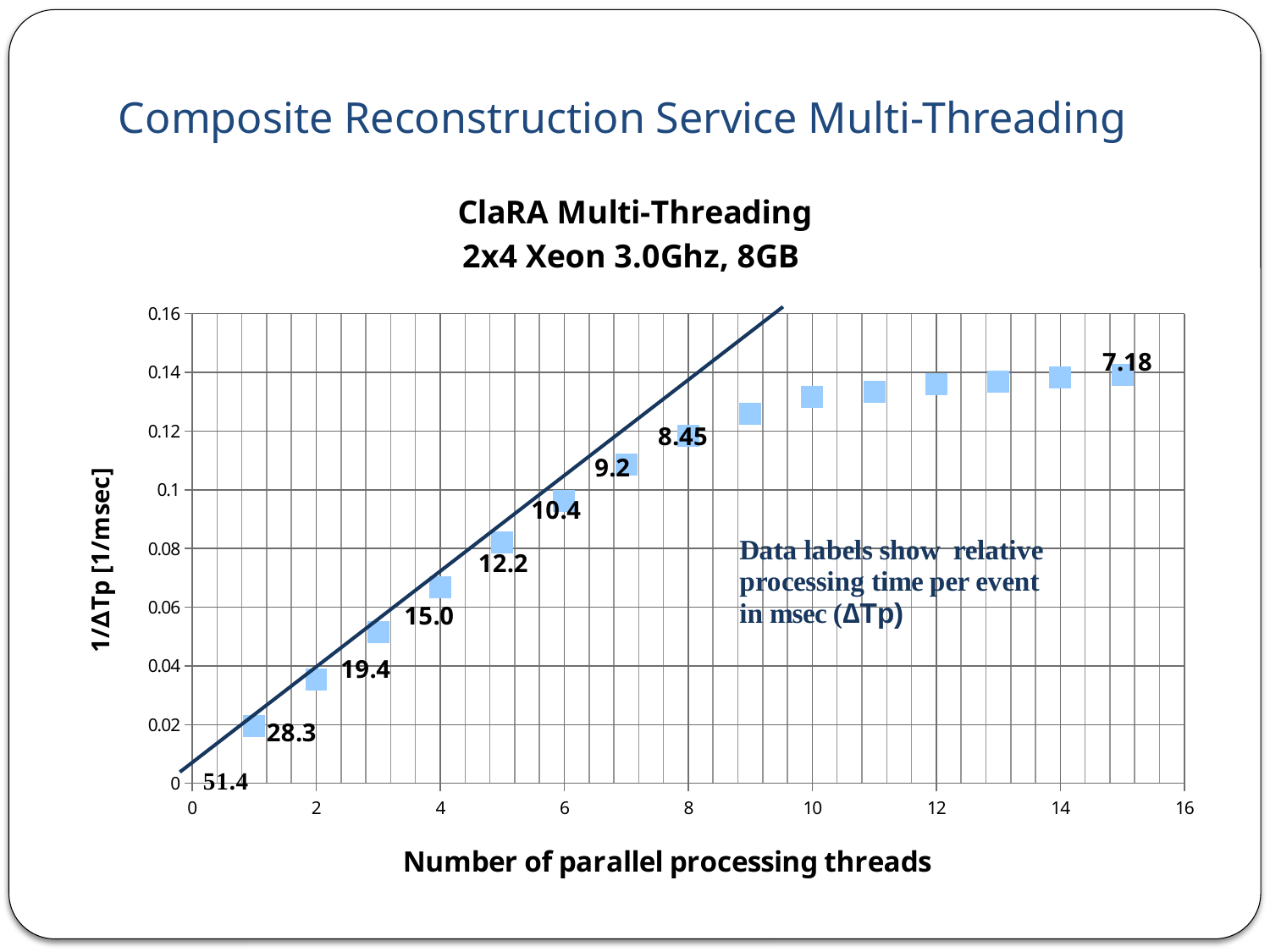
What is the label of the x axis? Number of parallel processing threads What kind of chart is shown on the slide? scatter chart Does 1/ΔTp rise or fall as the number of parallel processing threads increases? rises What is the largest data label value (ΔTp in msec) shown on the chart? 51.4 Which has the higher 1/ΔTp value: 4 threads or 10 threads? 10 threads Is the value of 1/ΔTp at 15 threads greater or less than 0.12? greater What is the title of the chart? ClaRA Multi-Threading 2x4 Xeon 3.0Ghz, 8GB Is the value of 1/ΔTp at 8 threads greater or less than 0.1? greater How many data points are plotted on the chart? 15 Is the value of 1/ΔTp at 1 thread greater or less than 0.04? less What is the smallest data label value (ΔTp in msec) shown on the chart? 7.18 What is the difference between the largest and smallest data label values shown (51.4 and 7.18)? 44.22